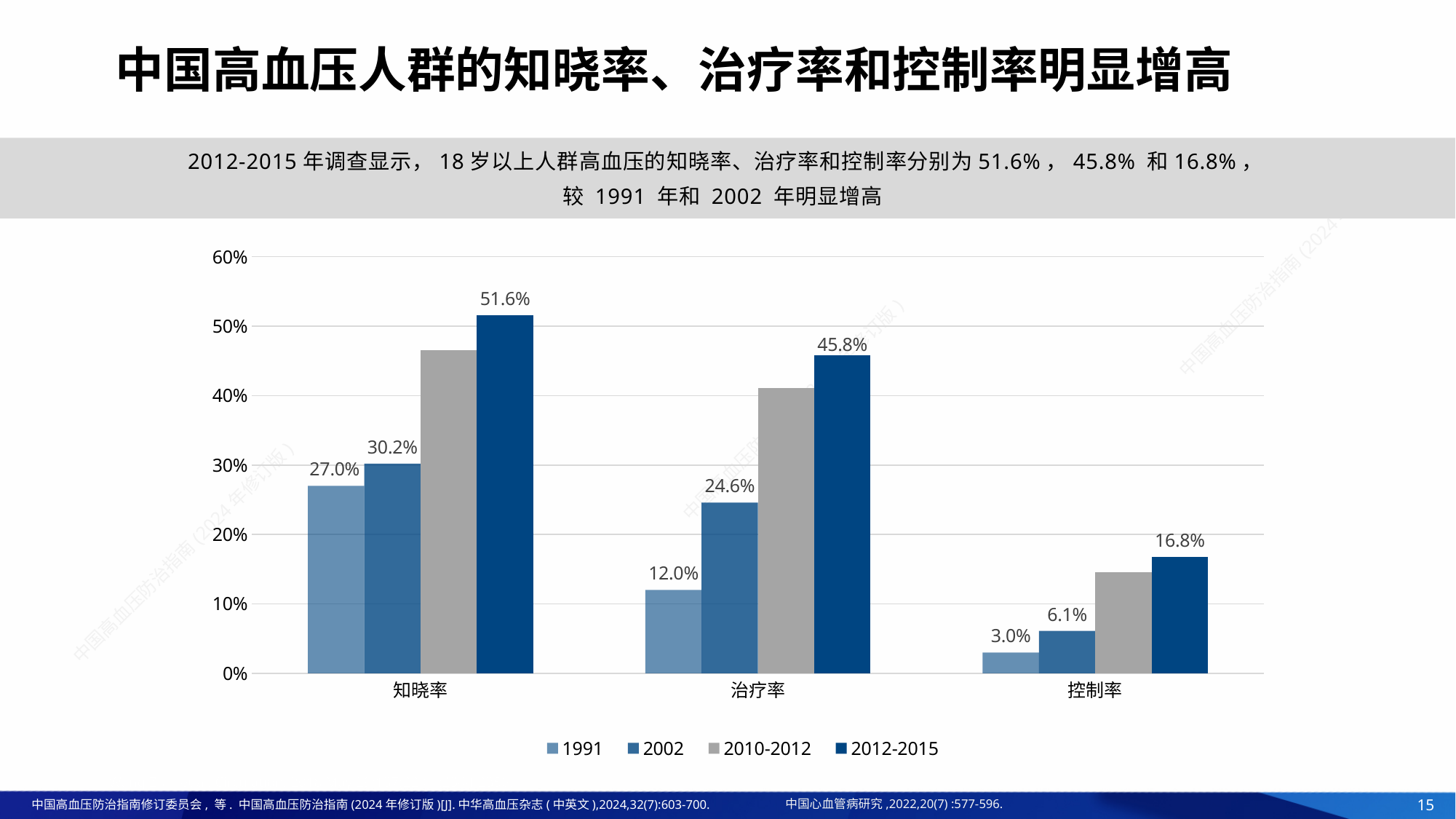
Which is larger: the 2012-2015 value for 治疗率 or the 2012-2015 value for 控制率? 治疗率 How many series does the legend list? 4 Which category has the highest value for the 2012-2015 series? 知晓率 What is the value for 1991 in the 治疗率 category? 12.0% Which category has the lowest value for the 1991 series? 控制率 What is the value for 2002 in the 控制率 category? 6.1% What is the difference between the 2012-2015 and 1991 values in the 知晓率 category? 24.6% Is the value for 2010-2012 in the 知晓率 category greater or less than 40%? greater Is the value for 2010-2012 in the 控制率 category greater or less than 10%? greater What is the difference between the 2002 and 1991 values in the 治疗率 category? 12.6% How many categories are shown on the x axis? 3 What is the value for 2012-2015 in the 知晓率 category? 51.6%